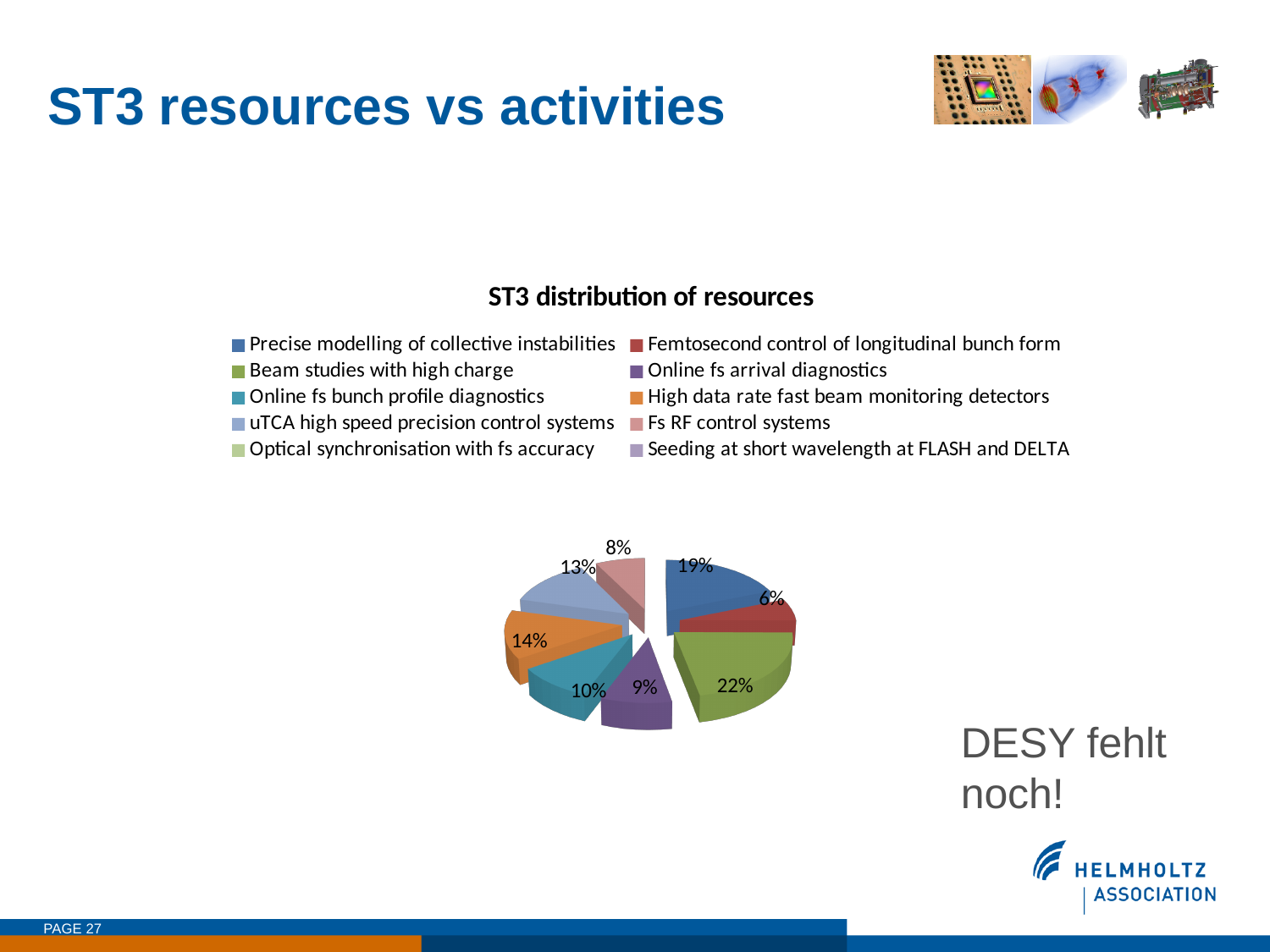
How many labelled slices are visible in the pie chart? 8 What is the smallest percentage shown on the pie chart? 6% How many entries does the chart's legend list? 10 What share of resources goes to 'Femtosecond control of longitudinal bunch form'? 6% Which is larger, the 14% slice or the 13% slice? 14% What is the largest percentage shown on the pie chart? 22% What share of resources goes to 'Precise modelling of collective instabilities'? 19% What is the title of the chart? ST3 distribution of resources What kind of chart is shown on the slide? pie chart What is the difference between the largest slice (22%) and the smallest slice (6%)? 16% What share of resources goes to 'Beam studies with high charge'? 22% Which legend entry is listed first in the legend? Precise modelling of collective instabilities